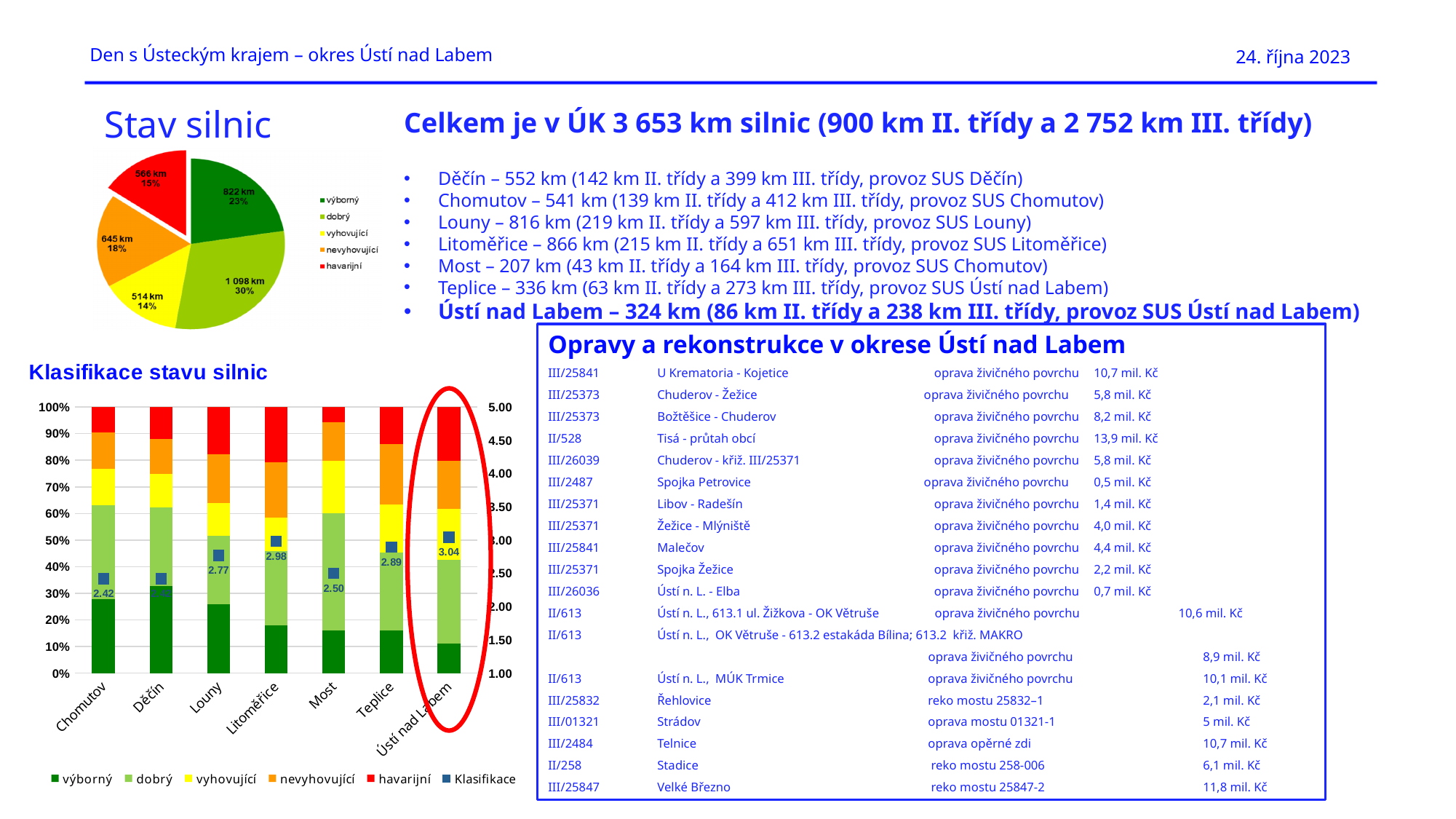
In the pie chart 'Stav silnic', what share of the roads is in the 'havarijní' category? 15% In the chart 'Klasifikace stavu silnic', which district has the highest Klasifikace value? Ústí nad Labem In the pie chart 'Stav silnic', which category has the largest slice? dobrý In the chart 'Klasifikace stavu silnic', what is the Klasifikace value for Litoměřice? 2.98 In the chart 'Klasifikace stavu silnic', what is the Klasifikace value for Ústí nad Labem? 3.04 In the chart 'Klasifikace stavu silnic', what is the difference between the Klasifikace values of Ústí nad Labem and Litoměřice? 0.06 In the pie chart 'Stav silnic', which category has the smallest slice? vyhovující How many districts are shown on the x axis of the chart 'Klasifikace stavu silnic'? 7 How many entries does the legend of the chart 'Klasifikace stavu silnic' list? 6 In the pie chart 'Stav silnic', how many km are in the 'dobrý' category? 1 098 km How many slices does the pie chart 'Stav silnic' have? 5 In the chart 'Klasifikace stavu silnic', which has the larger Klasifikace value, Louny or Most? Louny